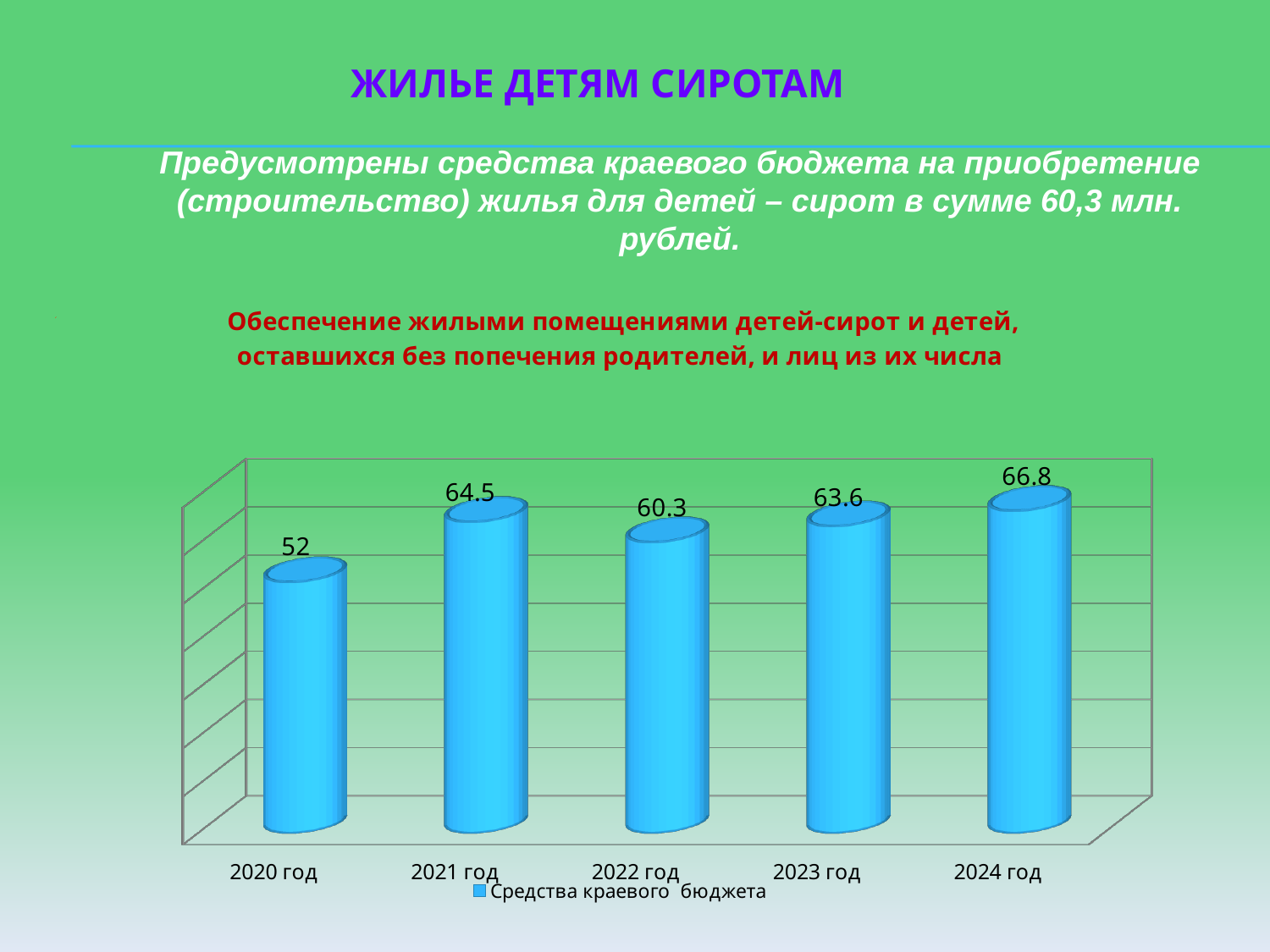
What is the difference between the values for 2021 год and 2020 год? 12.5 Which is larger, the value for 2021 год or the value for 2022 год? 2021 год What is the legend entry for the series? Средства краевого бюджета How many years are shown on the chart? 5 What kind of chart is shown? bar chart How many series does the legend list? 1 What is the difference between the values for 2024 год and 2023 год? 3.2 What is the value for 2022 год? 60.3 Which year has the lowest value? 2020 год What is the value for 2024 год? 66.8 Which year has the highest value? 2024 год What is the value for 2020 год? 52